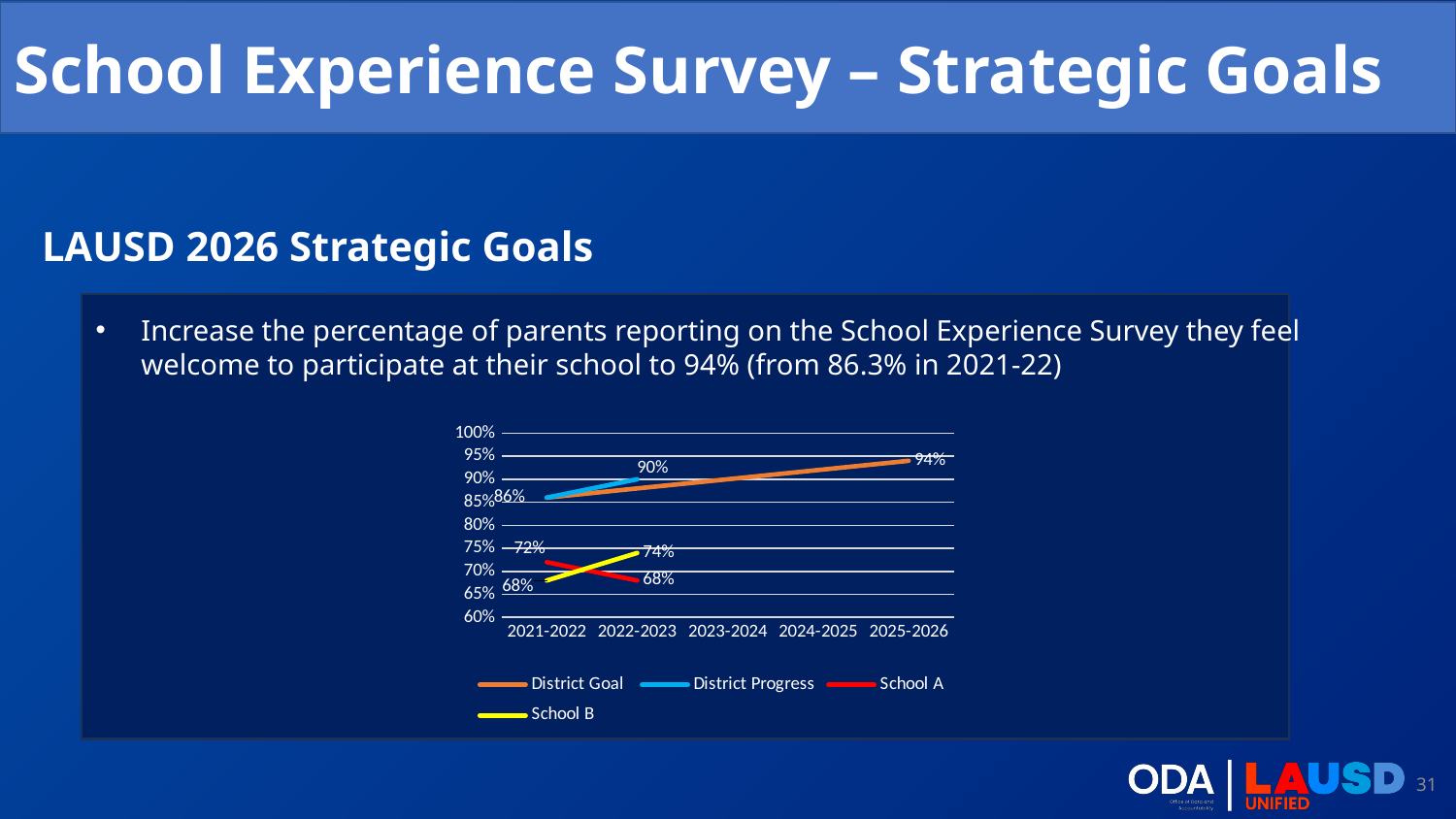
How many school years are shown on the x axis of the chart? 5 By how many percentage points does the District Goal line increase from 2021-2022 (86%) to 2025-2026 (94%)? 8 percentage points What is the School B value for 2022-2023? 74% How many series does the chart legend list? 4 In 2022-2023, which is higher: School A or School B? School B What kind of chart is shown on the slide? line chart Does the School B line rise or fall from 2021-2022 to 2022-2023? rise Does the School A line rise or fall from 2021-2022 to 2022-2023? fall What is the District Progress value for 2022-2023? 90% What is the District Goal value for 2025-2026? 94% What colour is the District Goal line in the chart legend? orange What is the School A value for 2021-2022? 72%